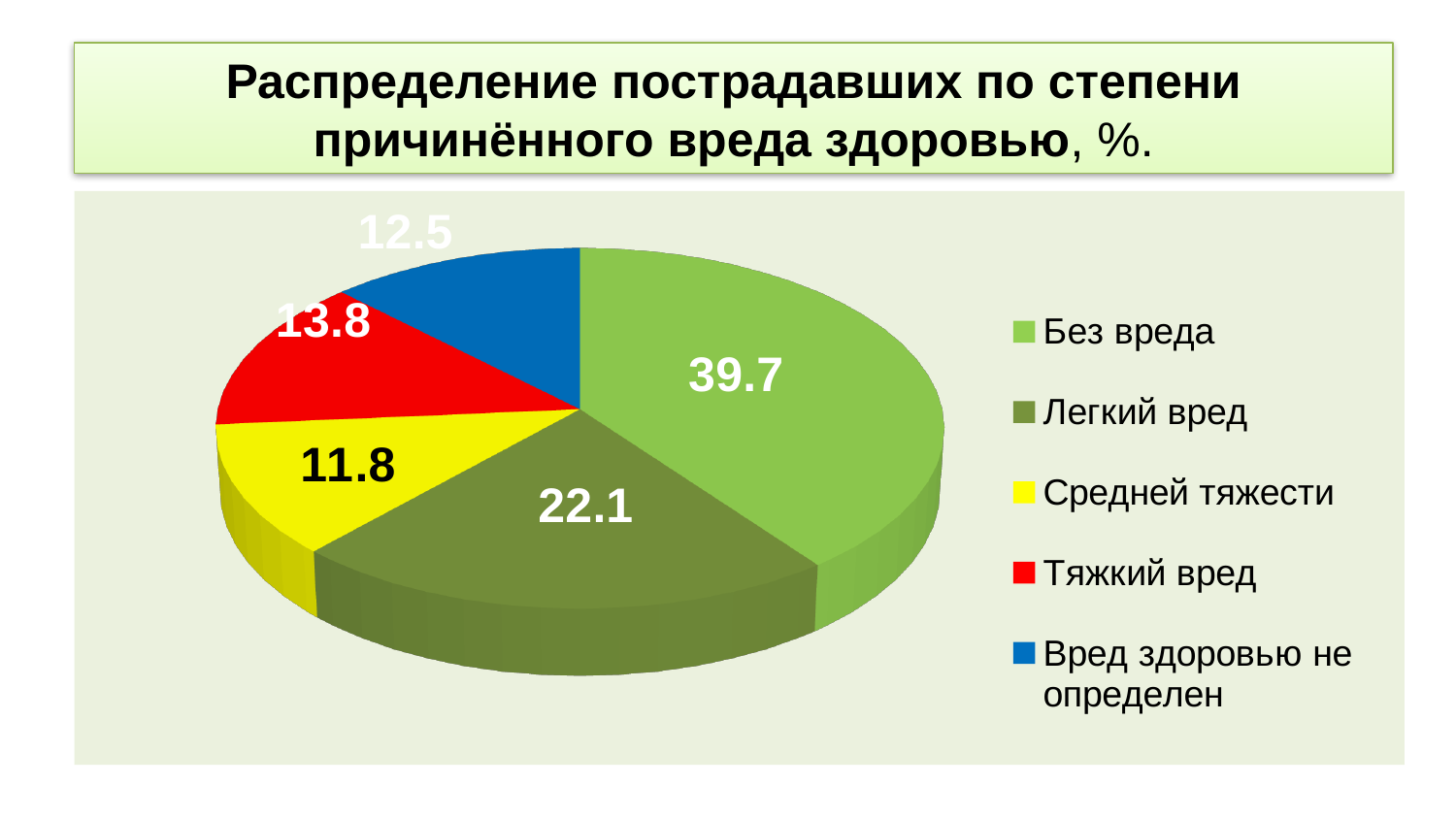
What is the value for "Без вреда"? 39.7 What is the difference between the values for "Без вреда" and "Легкий вред"? 17.6 What type of chart is shown on the slide? pie chart Which category has the smallest share of the pie? Средней тяжести What is the value for "Средней тяжести"? 11.8 What is the value for "Тяжкий вред"? 13.8 How many categories does the pie chart have? 5 What colour is the slice for "Тяжкий вред"? red Which is larger, the value for "Тяжкий вред" or the value for "Вред здоровью не определен"? Тяжкий вред What is the value for "Легкий вред"? 22.1 Which category has the largest share of the pie? Без вреда What is the value for "Вред здоровью не определен"? 12.5